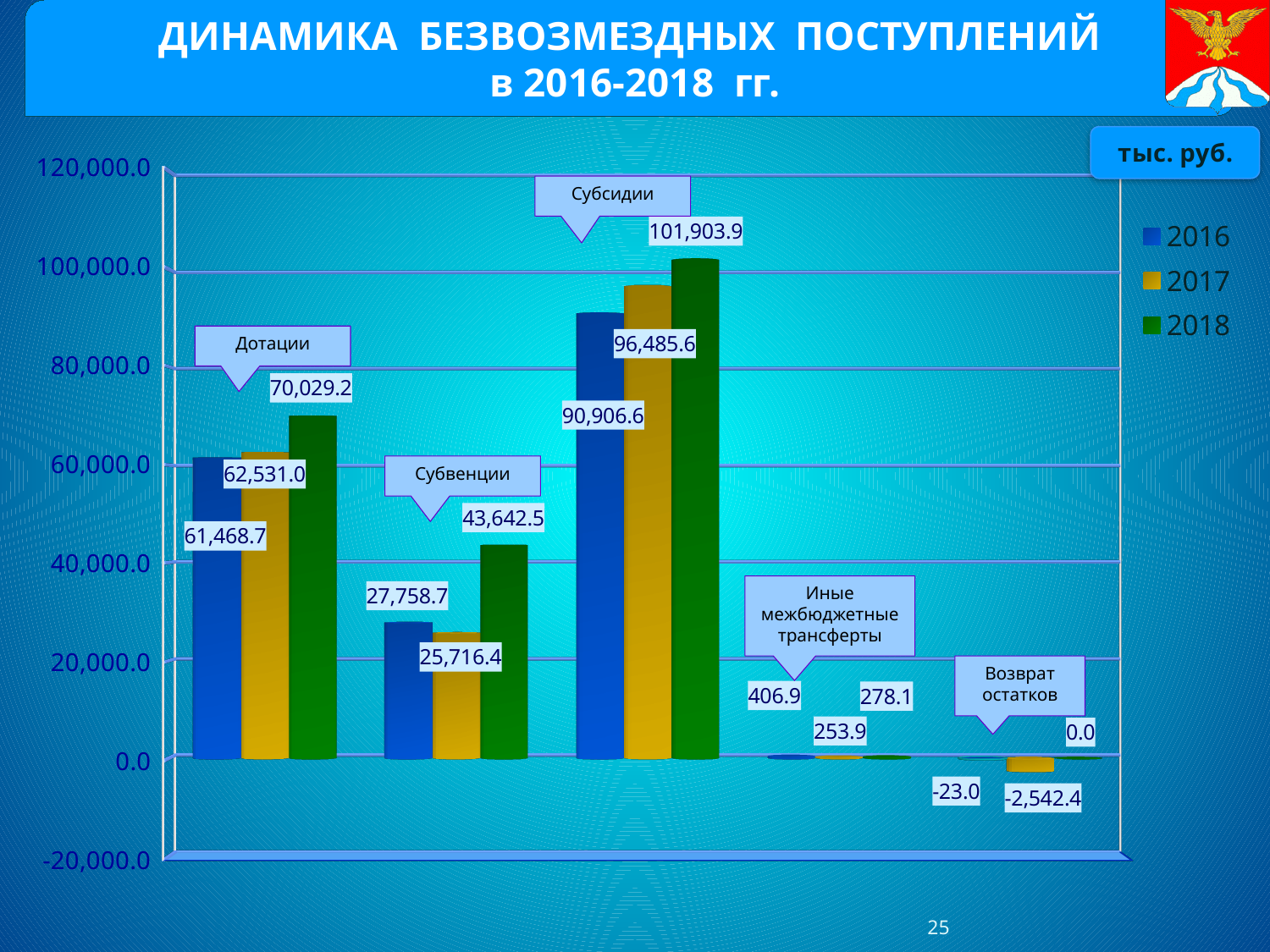
What is the value for Дотации in 2016? 61,468.7 Which is larger for Субвенции: the 2016 value or the 2017 value? 2016 What is the value for Субвенции in 2017? 25,716.4 What is the difference between the 2018 and 2016 values for Дотации? 8,560.5 What is the value for Возврат остатков in 2017? -2,542.4 How many series does the legend list? 3 Which category has the highest value in 2018? Субсидии Which category has the lowest value in 2017? Возврат остатков What is the value for Субсидии in 2018? 101,903.9 What type of chart is shown on the slide? bar chart How many categories are shown on the x axis? 5 Do the values for Субсидии rise or fall from 2016 to 2018? rise